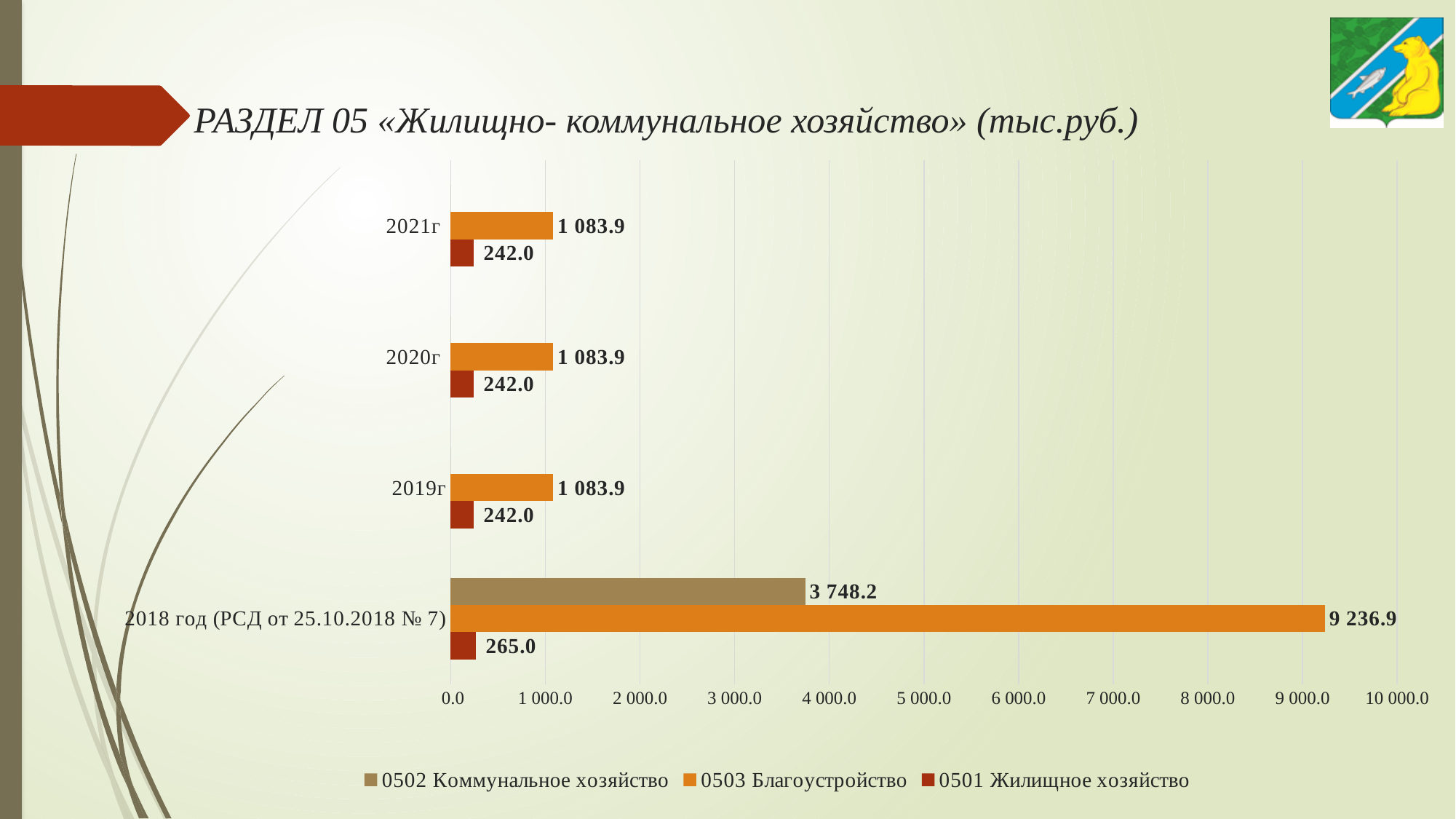
What is the value for 0503 Благоустройство in 2020г? 1 083.9 Which is larger in 2018 год (РСД от 25.10.2018 № 7): 0502 Коммунальное хозяйство or 0503 Благоустройство? 0503 Благоустройство How many year categories are shown on the chart? 4 What is the difference between 0503 Благоустройство and 0501 Жилищное хозяйство in 2021г? 841.9 What is the value for 0501 Жилищное хозяйство in 2021г? 242.0 What is the value for 0502 Коммунальное хозяйство in 2018 год (РСД от 25.10.2018 № 7)? 3 748.2 Which year has the highest value for 0503 Благоустройство? 2018 год (РСД от 25.10.2018 № 7) What is the value for 0503 Благоустройство in 2018 год (РСД от 25.10.2018 № 7)? 9 236.9 What type of chart is shown on the slide? bar chart What is the difference between the 0501 Жилищное хозяйство values for 2018 год (РСД от 25.10.2018 № 7) and 2019г? 23.0 What is the title of the chart on the slide? РАЗДЕЛ 05 «Жилищно- коммунальное хозяйство» (тыс.руб.) How many series does the legend list? 3